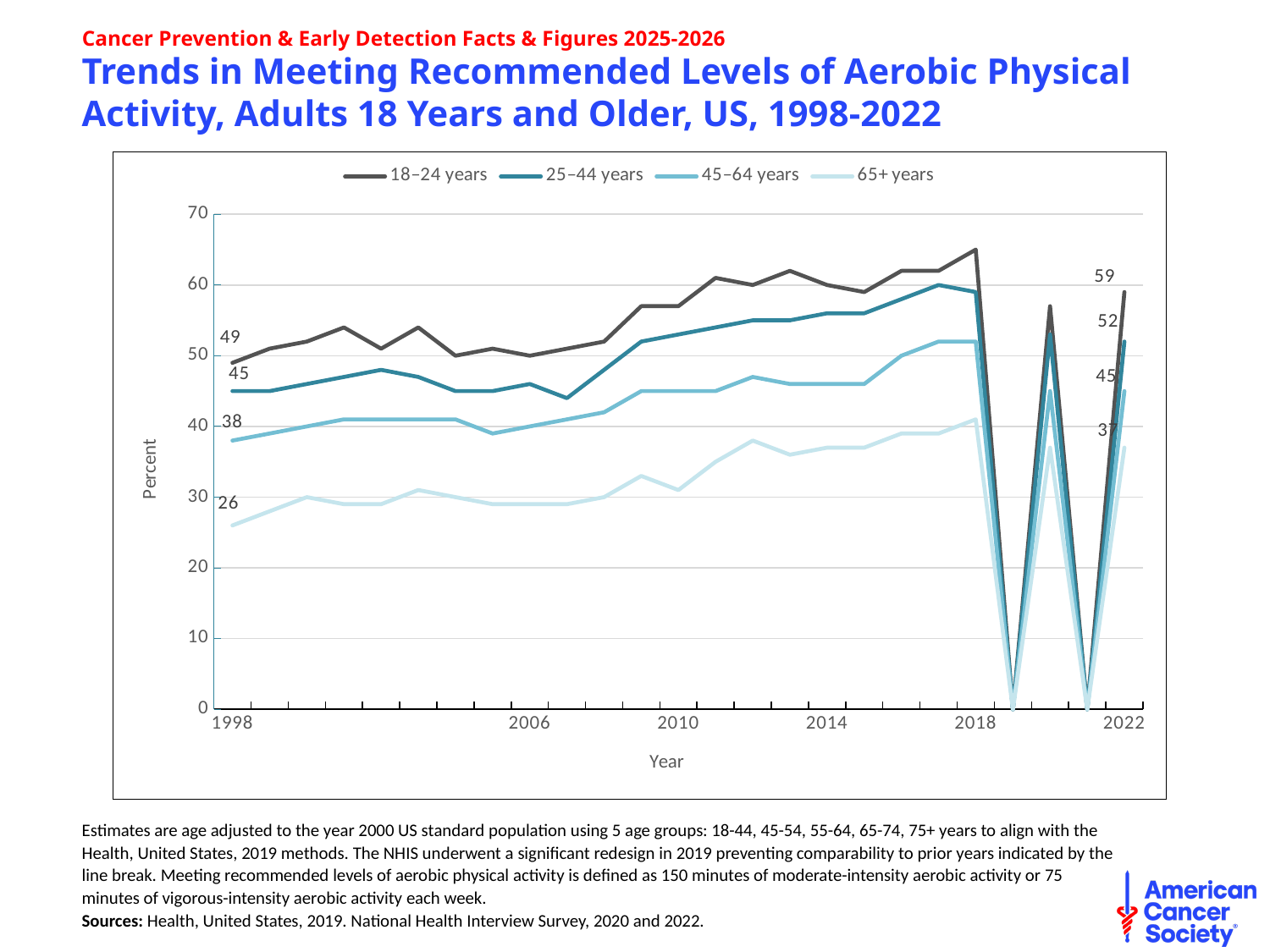
In 2022, which group had a higher value: 25–44 years or 45–64 years? 25–44 years By how many percentage points did the 18–24 years group increase from 1998 to 2022? 10 What type of chart is shown on the slide? Line chart How many age groups does the legend list? 4 Is the value for the 18–24 years group in 2018 greater or less than 60? greater Which age group had the lowest percentage in 1998? 65+ years What is the difference between the 18–24 years and 65+ years values in 2022? 22 What was the percentage of adults aged 18–24 years meeting recommended aerobic activity levels in 1998? 49 Which age group had the highest percentage in 2022? 18–24 years What value is shown for the 45–64 years group in 1998? 38 What value is shown for the 25–44 years group in 2022? 52 What was the percentage for the 65+ years group in 2022? 37